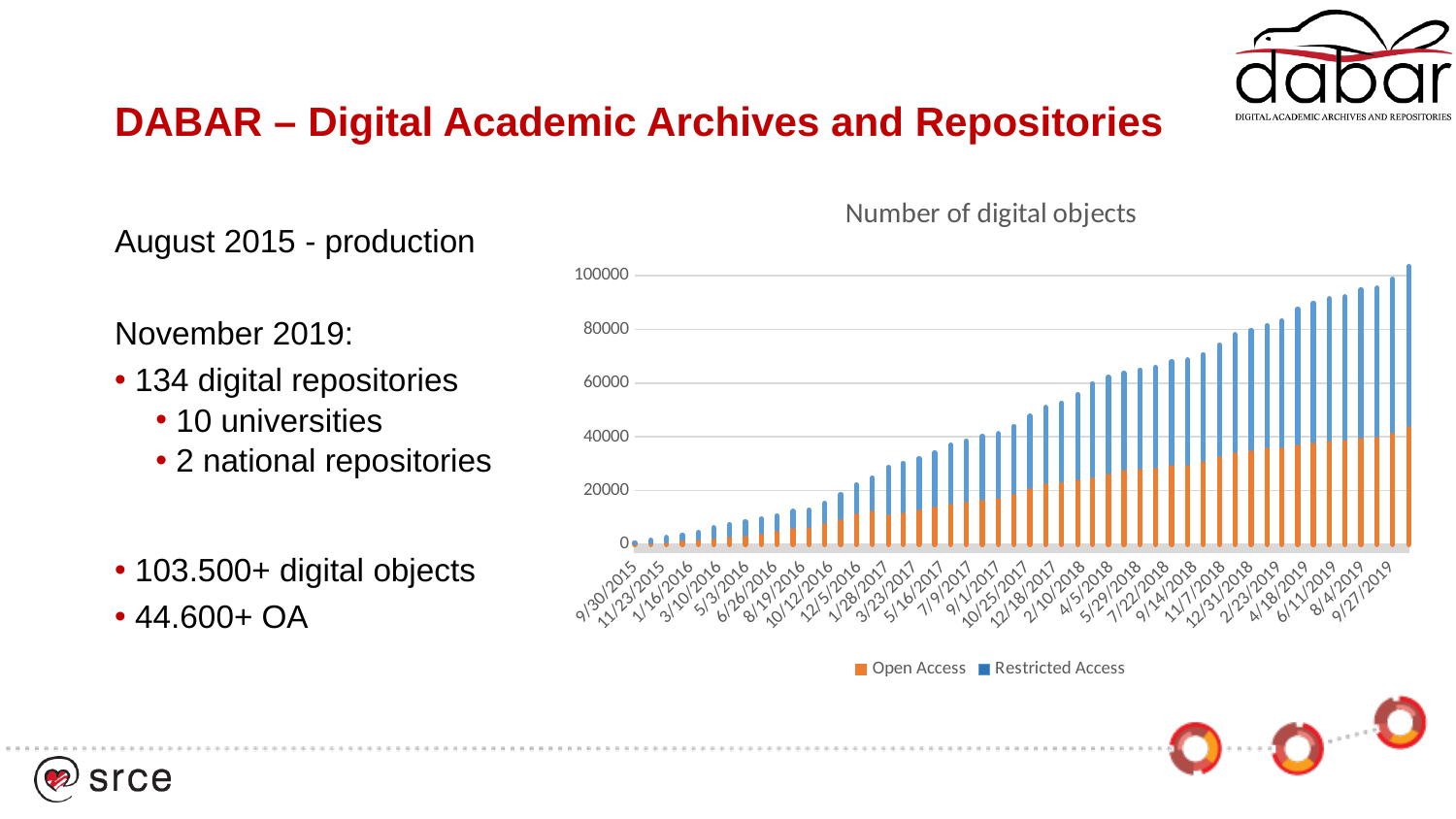
What kind of chart is shown on the slide? Stacked bar chart At 9/27/2019, which is larger: Open Access or Restricted Access? Restricted Access Is the total number of digital objects for 1/28/2017 greater or less than 40000? less What is the title of the chart? Number of digital objects Is the Open Access value for 9/27/2019 greater or less than 40000? greater How many series does the chart legend list? 2 Do the total number of digital objects rise or fall from 9/30/2015 to 9/27/2019? Rise Is the total number of digital objects for 9/30/2015 greater or less than 20000? less Which colour represents Open Access in the chart? Orange Which date has the lowest total number of digital objects? 9/30/2015